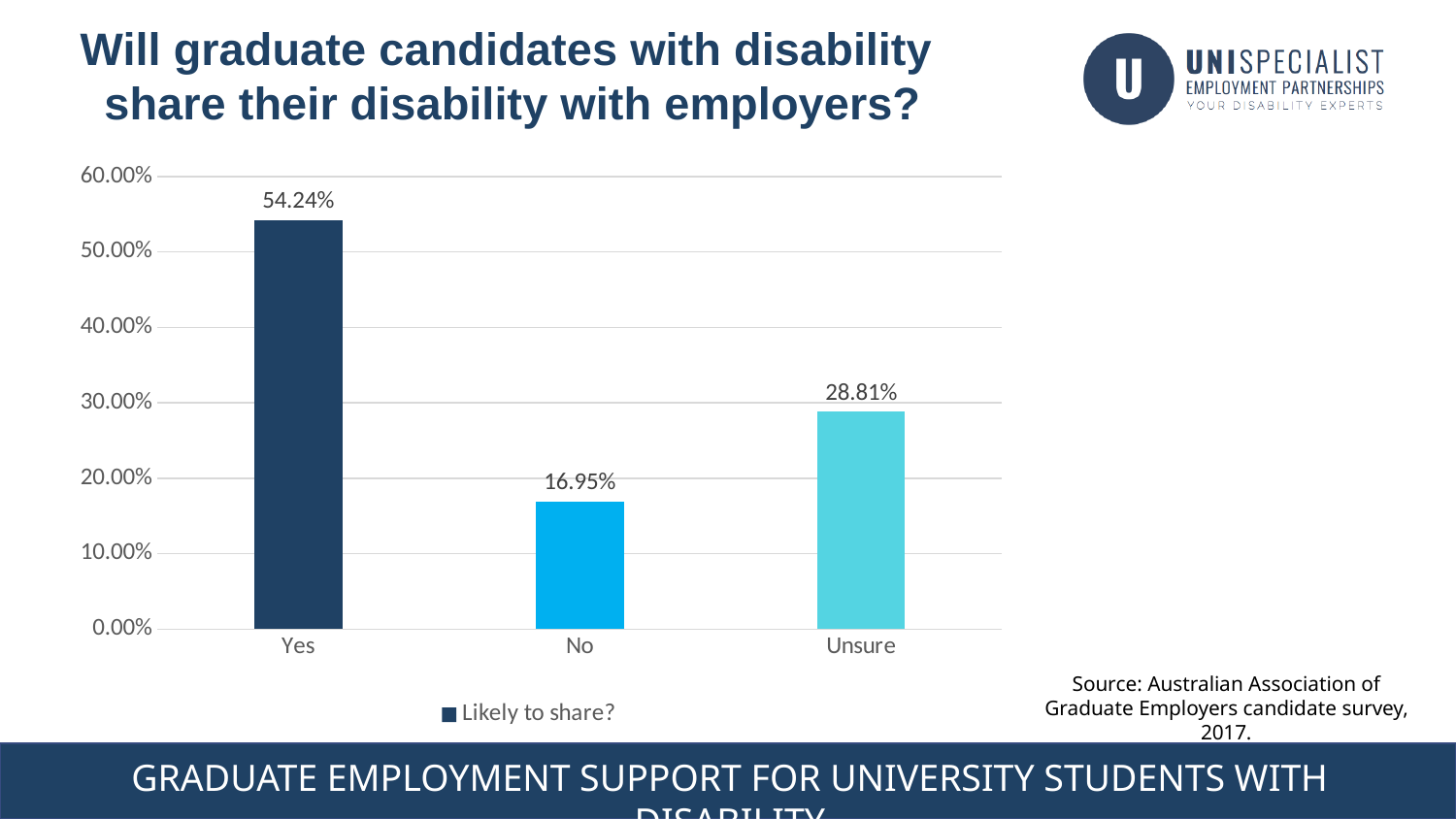
What is the value for No? 16.95% Which category has the highest value? Yes Which category has the lowest value? No What is the value for Yes? 54.24% How many categories are shown on the x axis? 3 Which is larger, the value for No or the value for Unsure? Unsure What is the difference between the values for Unsure and No? 11.86% What is the difference between the values for Yes and Unsure? 25.43% What series name does the legend show? Likely to share? What is the value for Unsure? 28.81% Is the value for Yes greater or less than 50.00%? greater What kind of chart is shown on the slide? bar chart